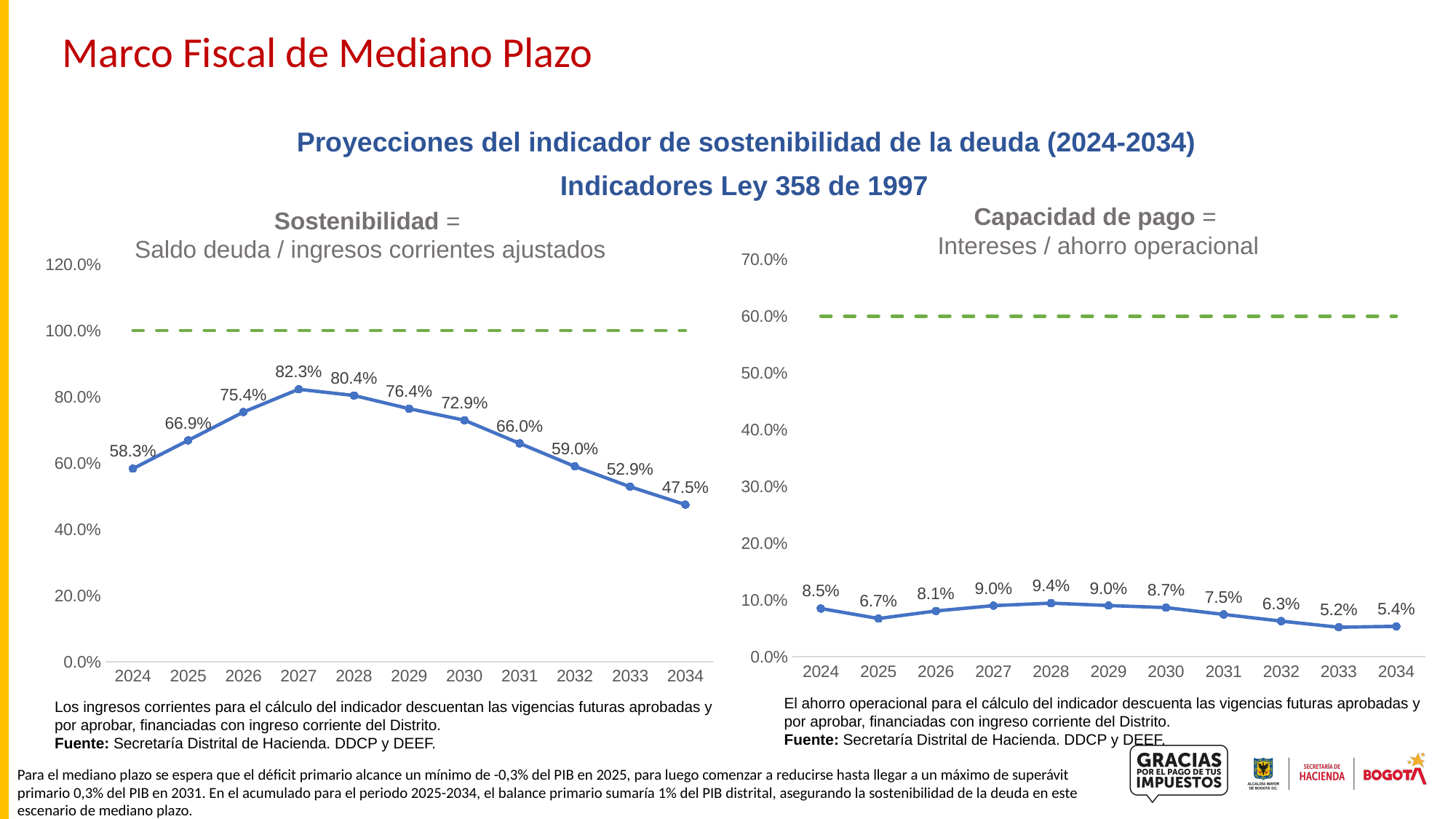
In the Sostenibilidad chart, which year has the highest value? 2027 In the Sostenibilidad chart, how many years are plotted on the x axis? 11 In the Sostenibilidad chart, what is the value for 2027? 82.3% In the Capacidad de pago chart, which is larger, the value for 2024 or the value for 2025? 2024 In the Sostenibilidad chart, what is the difference between the 2024 value and the 2025 value? 8.6% In the Capacidad de pago chart, what is the difference between the 2028 value and the 2034 value? 4.0% In the Sostenibilidad chart, what is the value for 2034? 47.5% What kind of chart is the Capacidad de pago chart? Line chart In the Sostenibilidad chart, at what level is the green dashed line drawn? 100.0% In the Capacidad de pago chart, which year has the lowest value? 2033 In the Sostenibilidad chart, which year has the lowest value? 2034 In the Capacidad de pago chart, what is the value for 2028? 9.4%